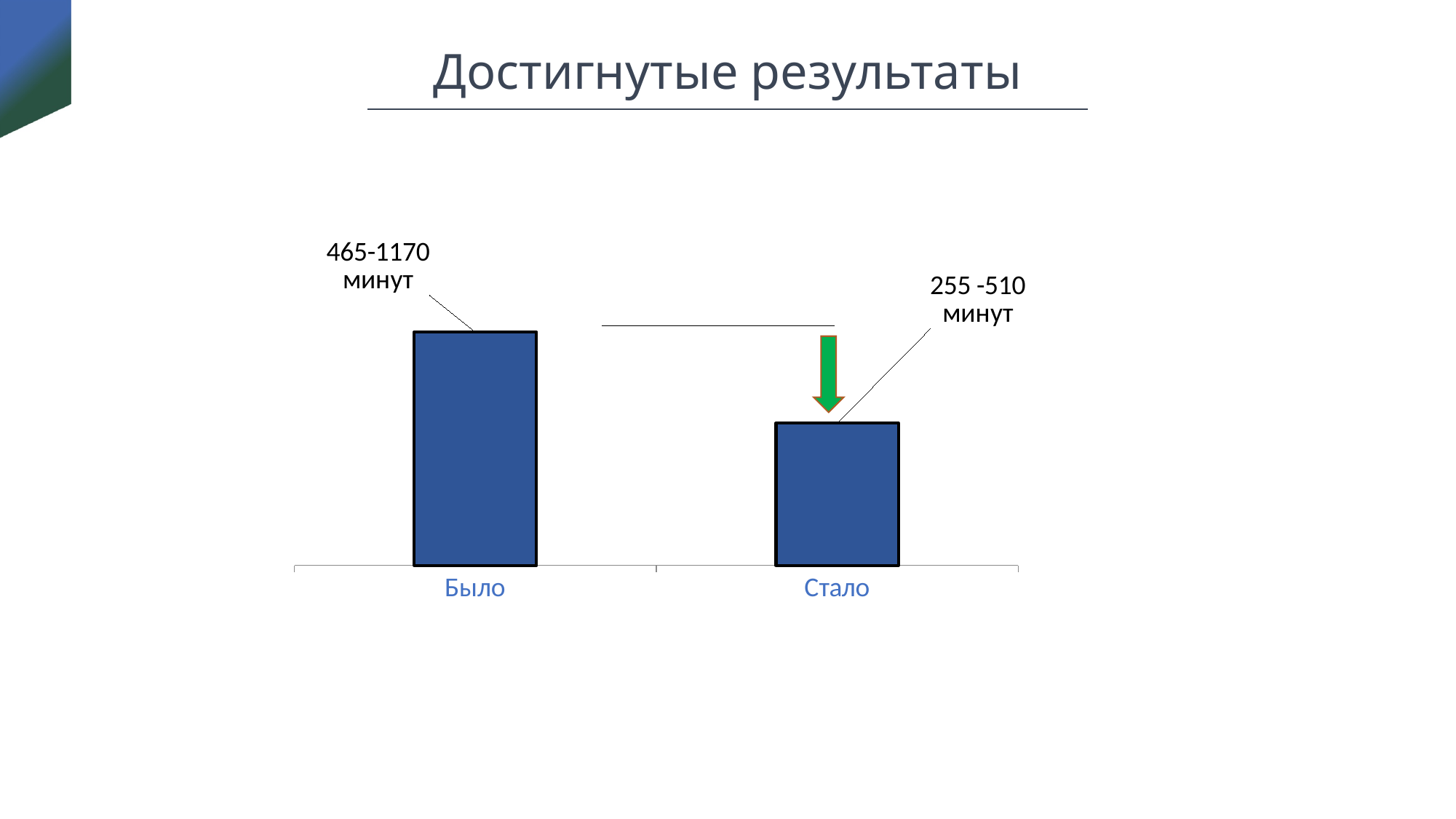
What label is shown for the "Стало" bar? 255 -510 минут Which category has the shorter bar? Стало What label is shown for the "Было" bar? 465-1170 минут What are the two category labels on the x axis? Было, Стало Is the bar for "Было" taller or shorter than the bar for "Стало"? taller Which category has the taller bar? Было What kind of chart is shown on the slide? bar chart Do the bar heights rise or fall from "Было" to "Стало"? fall How many bars are plotted in the chart? 2 What is the title of the slide containing the chart? Достигнутые результаты